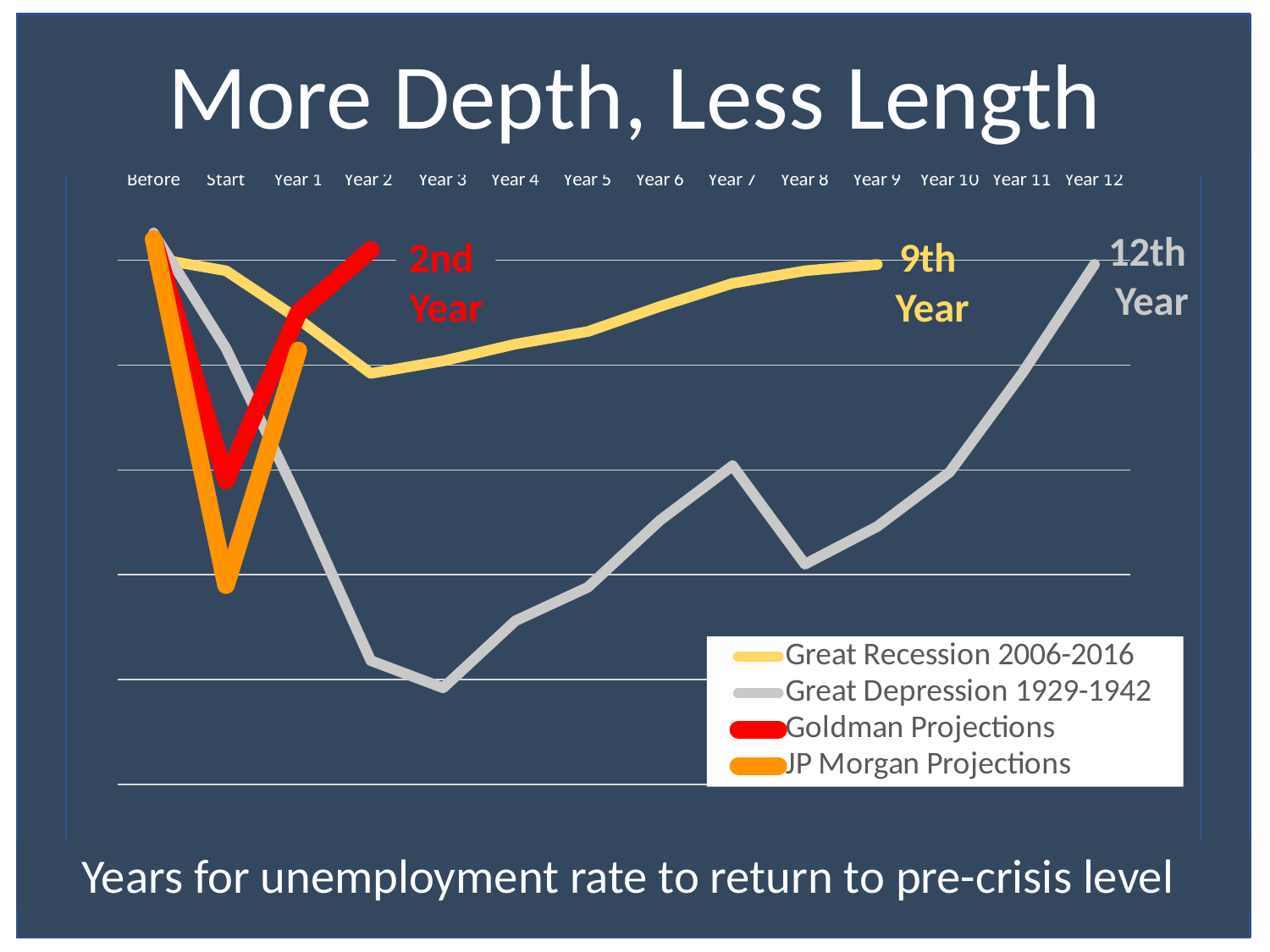
At the Start category, which is lower: the Goldman Projections line or the JP Morgan Projections line? JP Morgan Projections How many series does the legend list? 4 Which series has the shallowest dip below the pre-crisis level? Great Recession 2006-2016 Which series drops to the lowest point on the chart? Great Depression 1929-1942 According to the annotation, in which year do the Goldman Projections return to the pre-crisis level? 2nd Year How many categories are shown along the x axis? 14 According to the annotation, in which year does the Great Depression 1929-1942 line return to the pre-crisis level? 12th Year What kind of chart is shown on the slide? Line chart What colour is the Great Recession 2006-2016 line in the legend? Yellow At which x-axis category does the Great Depression 1929-1942 line reach its lowest point? Year 3 According to the annotation, in which year does the Great Recession 2006-2016 line return to the pre-crisis level? 9th Year Does the Great Depression 1929-1942 line rise or fall from Year 8 to Year 12? Rise